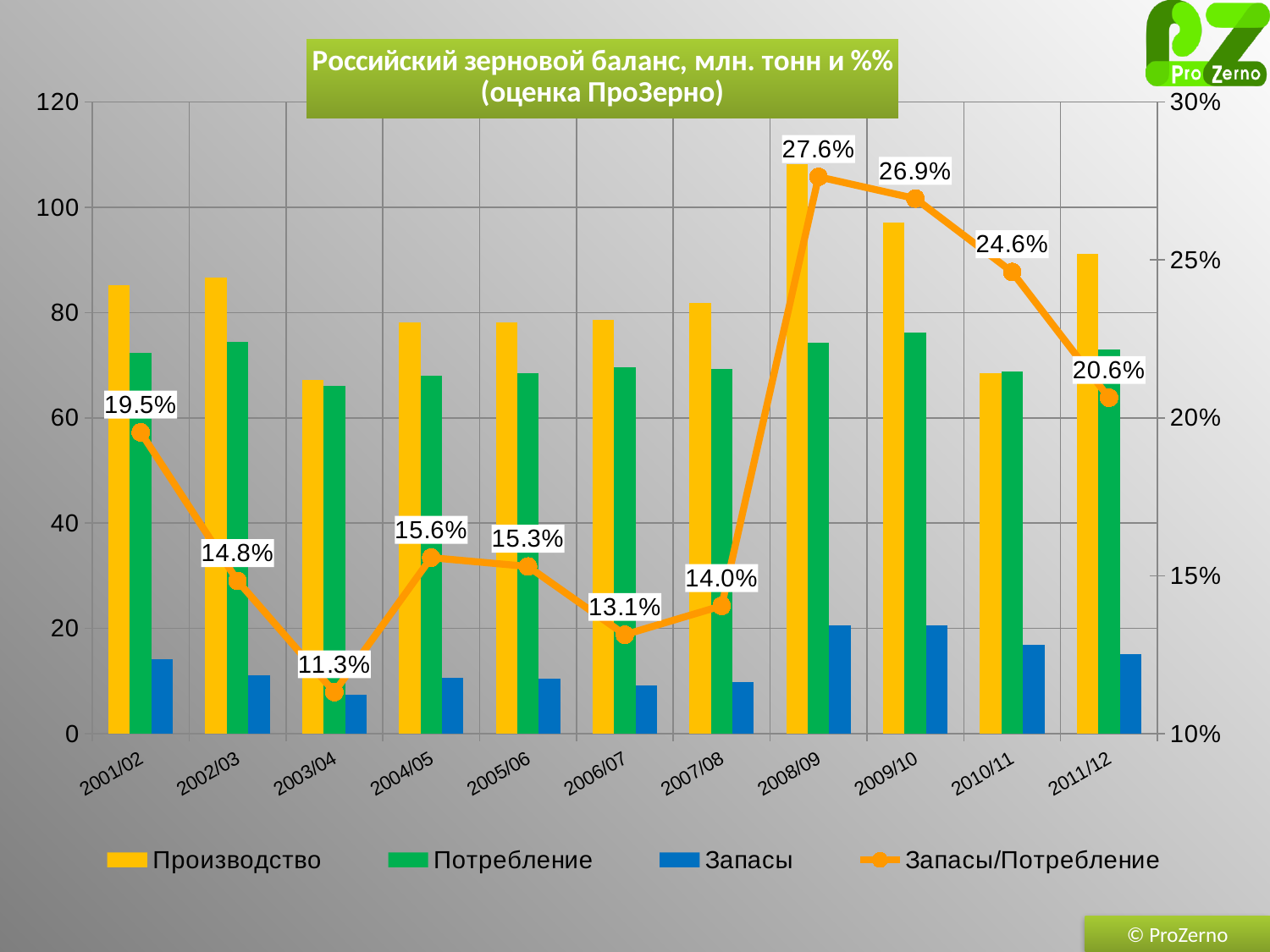
What kind of chart is shown on the slide? Combination bar and line chart Is the Запасы value for 2003/04 greater or less than 20? less In which season is the Запасы/Потребление ratio lowest? 2003/04 What is the value of Запасы/Потребление for 2008/09? 27.6% What is the value of Запасы/Потребление for 2003/04? 11.3% What is the value of Запасы/Потребление for 2011/12? 20.6% How many seasons are shown on the x axis? 11 By how many percentage points does Запасы/Потребление in 2008/09 exceed that in 2011/12? 7.0 percentage points In which season is the Запасы/Потребление ratio highest? 2008/09 Is the Производство value for 2008/09 greater or less than 100? greater How many series does the legend list? 4 Which season has the larger Запасы/Потребление ratio, 2004/05 or 2005/06? 2004/05